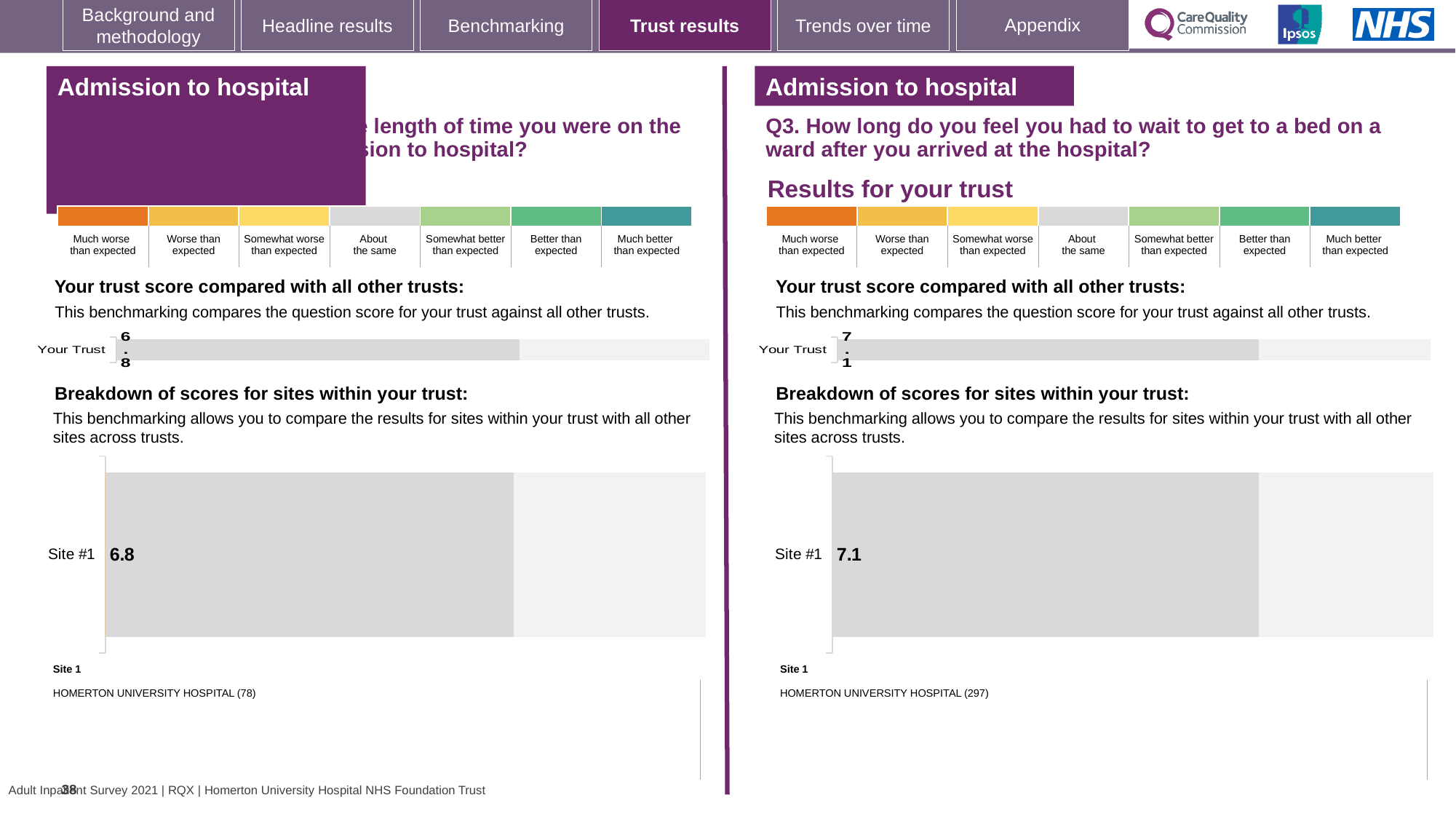
On the left-hand 'Your trust score compared with all other trusts' chart, what is the score shown for Your Trust? 6.8 Is the Site #1 score on the left-hand breakdown chart equal to the Your Trust score on the left-hand trust chart? Yes What kind of chart is used to show the Site #1 score on the left-hand breakdown chart? Bar chart Which is larger: the Site #1 score on the left-hand breakdown chart or the Site #1 score on the right-hand (Q3) breakdown chart? The right-hand (Q3) chart How many sites are plotted on the right-hand (Q3) 'Breakdown of scores for sites within your trust' chart? 1 On the right-hand (Q3) 'Breakdown of scores for sites within your trust' chart, what is the score for Site #1? 7.1 On the left-hand 'Breakdown of scores for sites within your trust' chart, what is the score for Site #1? 6.8 Which site is listed as Site 1 beneath the right-hand (Q3) breakdown chart? HOMERTON UNIVERSITY HOSPITAL (297) Which site is listed as Site 1 beneath the left-hand breakdown chart? HOMERTON UNIVERSITY HOSPITAL (78) On the right-hand (Q3) 'Your trust score compared with all other trusts' chart, what is the score shown for Your Trust? 7.1 How many bars are shown on the left-hand 'Your trust score compared with all other trusts' chart? 1 What is the difference between the Your Trust score on the right-hand (Q3) chart and the Your Trust score on the left-hand chart? 0.3